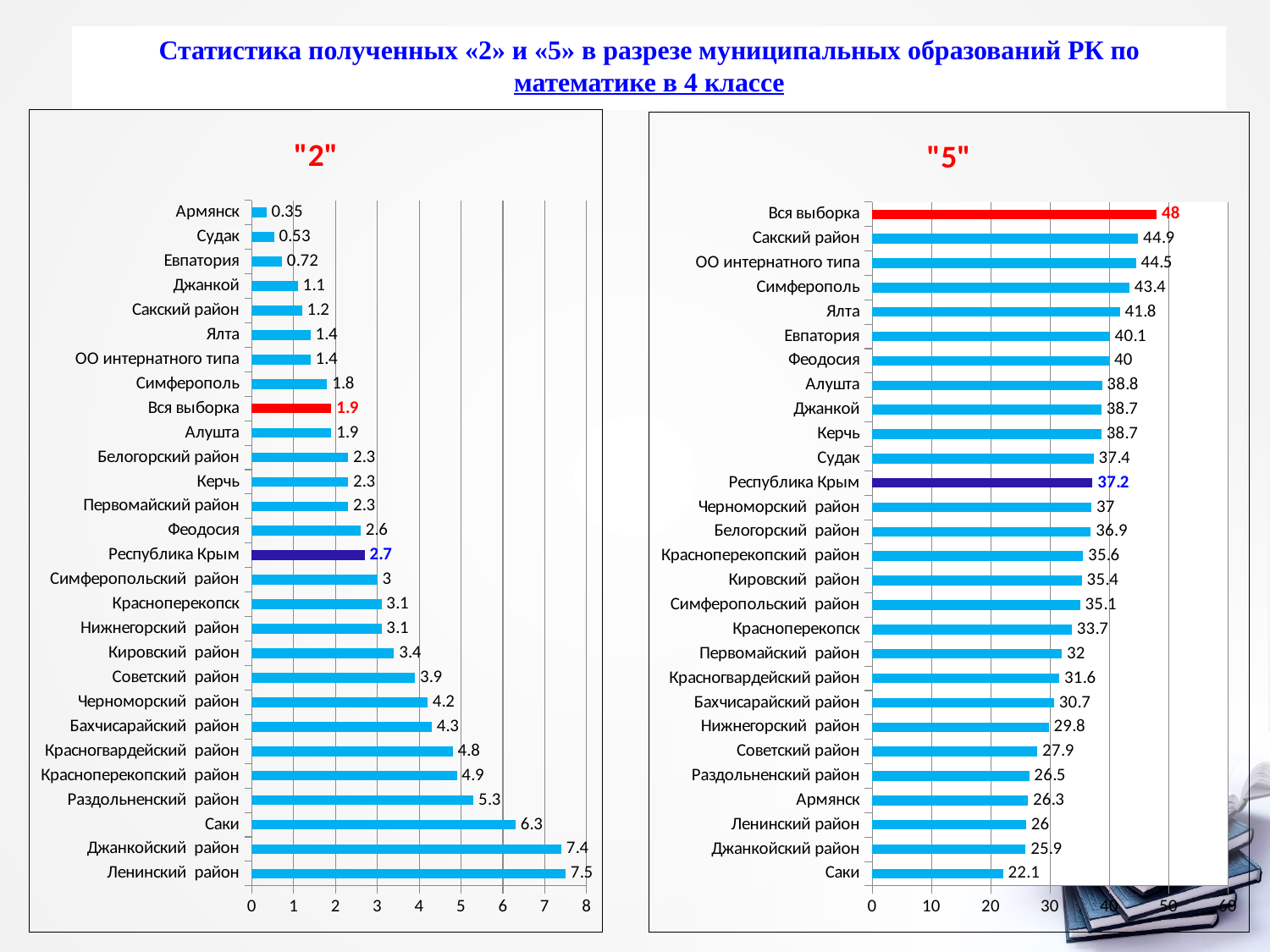
In the "5" chart, how many categories are plotted? 28 In the "2" chart, what is the difference between Джанкойский район and Саки? 1.1 In the "5" chart, which category has the lowest value? Саки In the "2" chart, which is larger: Советский район or Кировский район? Советский район In the "2" chart, what colour is the bar for Вся выборка? Red In the "2" chart, which category has the lowest value? Армянск In the "5" chart, what is the difference between Сакский район and Симферополь? 1.5 In the "2" chart, what is the value for Республика Крым? 2.7 What kind of chart is the "5" chart? Bar chart In the "5" chart, what is the value for Вся выборка? 48 In the "2" chart, what is the value for Ленинский район? 7.5 In the "5" chart, what is the value for Республика Крым? 37.2